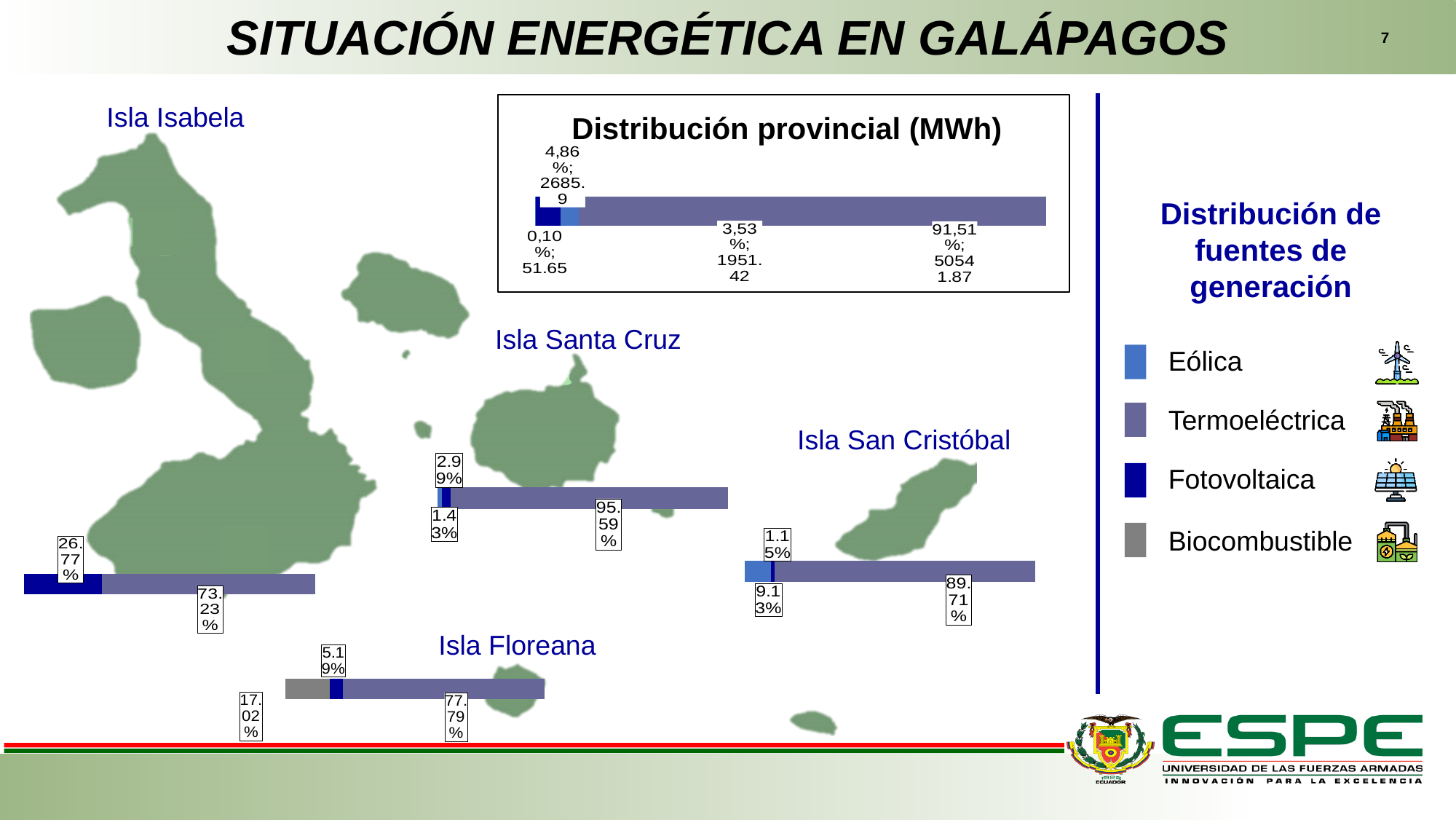
On the Isla San Cristóbal bar, what share is labelled for the Eólica (light blue) segment? 9.13% On the Isla Isabela bar, what share is labelled for the Termoeléctrica segment? 73.23% On the Isla Santa Cruz bar, what share is labelled for the Termoeléctrica segment? 95.59% Among the four island bars, which island has the highest Termoeléctrica share? Isla Santa Cruz On the Isla San Cristóbal bar, what is the difference between the Termoeléctrica share and the Eólica share? 80.58% Which is larger: the Fotovoltaica share on Isla Isabela or the Biocombustible share on Isla Floreana? Fotovoltaica share on Isla Isabela How many generation sources does the legend 'Distribución de fuentes de generación' list? 4 What kind of chart is 'Distribución provincial (MWh)'? Bar chart In the 'Distribución provincial (MWh)' chart, what is the largest percentage shown? 91,51% On the Isla Isabela bar, what share is labelled for the Fotovoltaica (dark blue) segment? 26.77% On the Isla Floreana bar, what share is labelled for the Biocombustible (grey) segment? 17.02% In the 'Distribución provincial (MWh)' chart, what MWh value accompanies the 4,86% label? 2685.9